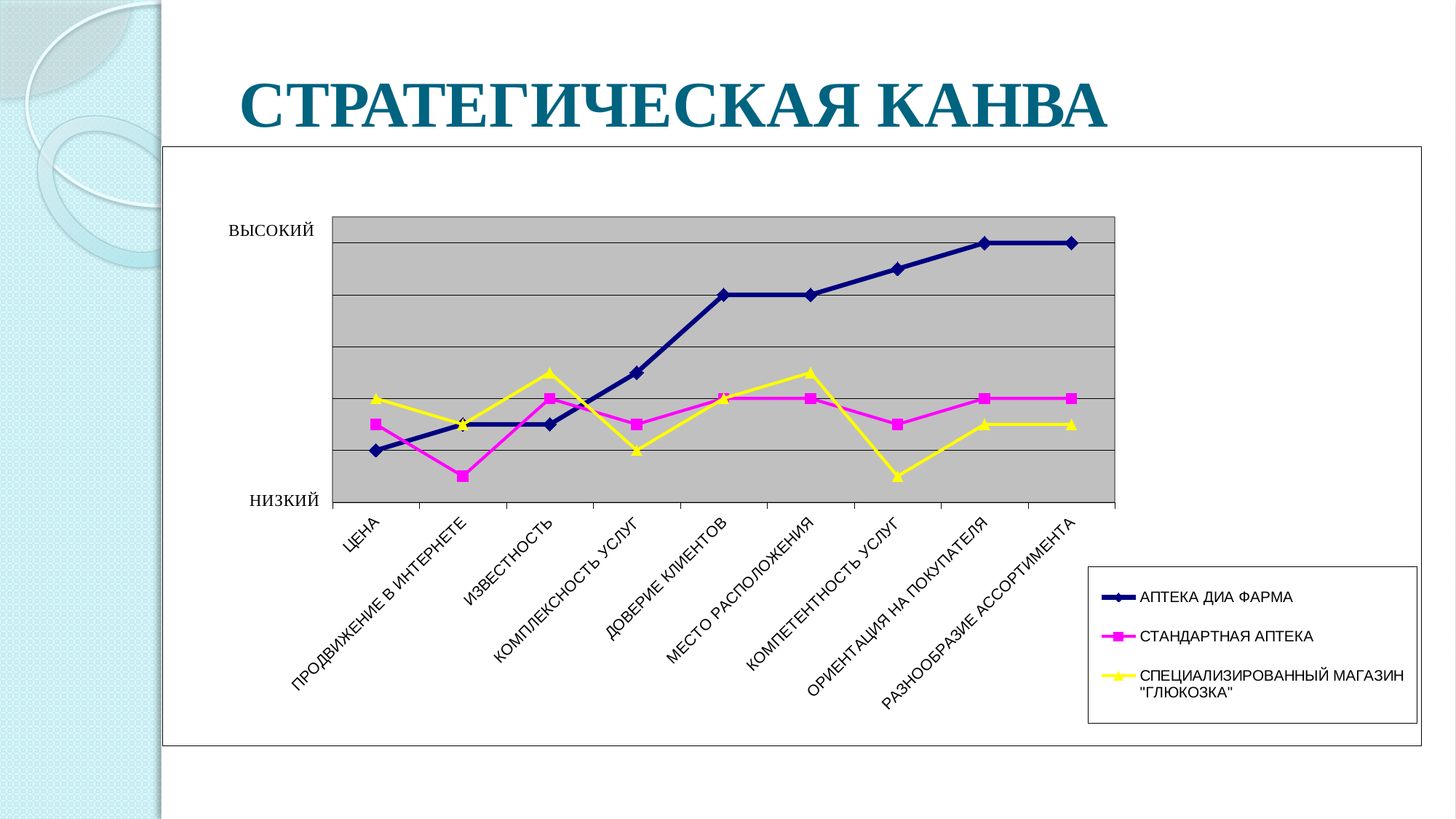
What kind of chart is shown on the slide? line chart What is the title of the slide containing the chart? СТРАТЕГИЧЕСКАЯ КАНВА Which series has the lowest value for ЦЕНА? АПТЕКА ДИА ФАРМА How many categories are shown on the x axis? 9 For which category is the value of СТАНДАРТНАЯ АПТЕКА lowest? ПРОДВИЖЕНИЕ В ИНТЕРНЕТЕ Does the АПТЕКА ДИА ФАРМА line generally rise or fall from ЦЕНА to РАЗНООБРАЗИЕ АССОРТИМЕНТА? rise Which series has the highest value for РАЗНООБРАЗИЕ АССОРТИМЕНТА? АПТЕКА ДИА ФАРМА How many series does the legend list? 3 Which series has the highest value for ЦЕНА? СПЕЦИАЛИЗИРОВАННЫЙ МАГАЗИН "ГЛЮКОЗКА" For which category is the value of СПЕЦИАЛИЗИРОВАННЫЙ МАГАЗИН "ГЛЮКОЗКА" lowest? КОМПЕТЕНТНОСТЬ УСЛУГ For which category is the value of АПТЕКА ДИА ФАРМА lowest? ЦЕНА